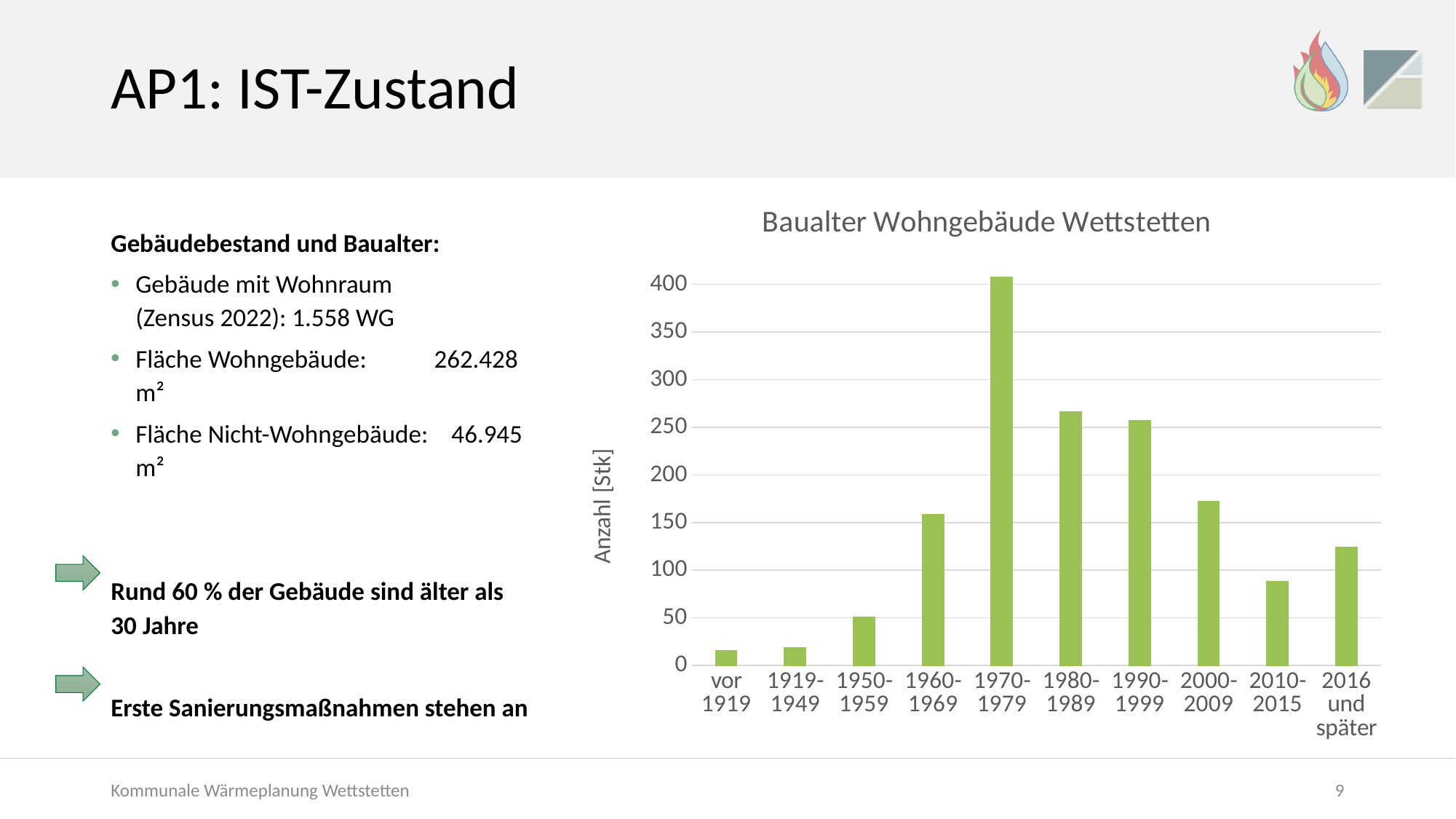
Is the value for 2000-2009 greater or less than 200? less Is the value for 1970-1979 greater or less than 350? greater Is the value for 2010-2015 greater or less than 100? less Which building-age category has the highest number of residential buildings? 1970-1979 What is the title of the chart? Baualter Wohngebäude Wettstetten Which has more residential buildings: 2010-2015 or 2016 und später? 2016 und später How many building-age categories are shown on the x axis of the chart? 10 What kind of chart is shown on the slide? bar chart What is the label of the vertical axis of the chart? Anzahl [Stk] Do the values rise or fall from 1970-1979 to 2010-2015? fall